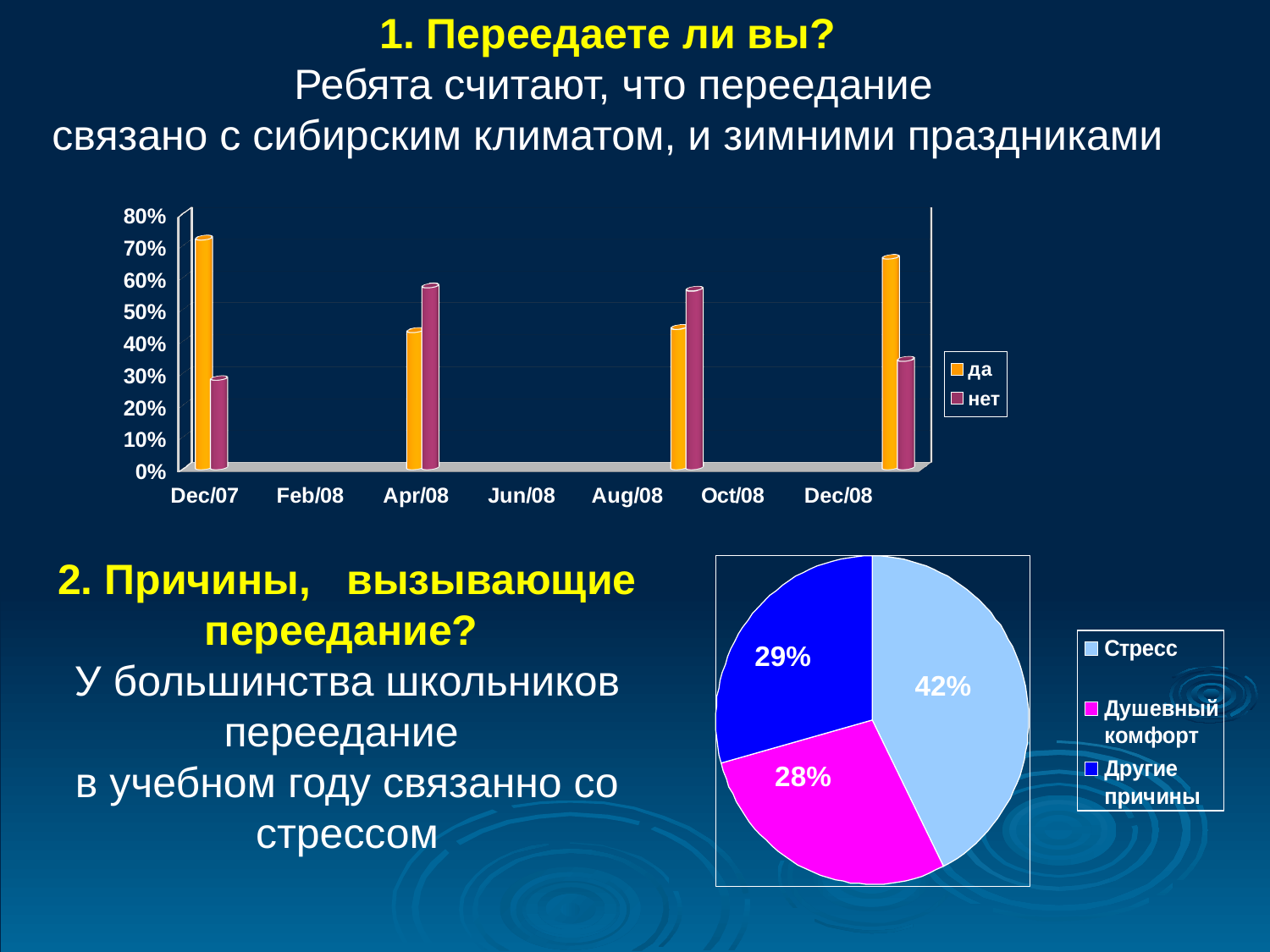
How many series does the legend of the top bar chart list? 2 In the top bar chart, which is larger at Apr/08, 'да' or 'нет'? нет In the bottom pie chart, what is the difference between the 'Стресс' share and the 'Душевный комфорт' share? 14% In the top bar chart, is the value for 'нет' at Dec/07 greater or less than 40%? less In the bottom pie chart, which category has the largest slice? Стресс In the bottom pie chart, what share is labelled for 'Душевный комфорт'? 28% What kind of chart is the bottom chart on the slide? pie chart In the bottom pie chart, what share is labelled for 'Стресс'? 42% In the top bar chart, is the value for 'да' at Dec/07 greater or less than 60%? greater What kind of chart is the top chart on the slide? bar chart In the top bar chart, which is larger at Dec/08, 'да' or 'нет'? да In the top bar chart, is the value for 'нет' at Aug/08 greater or less than 50%? greater